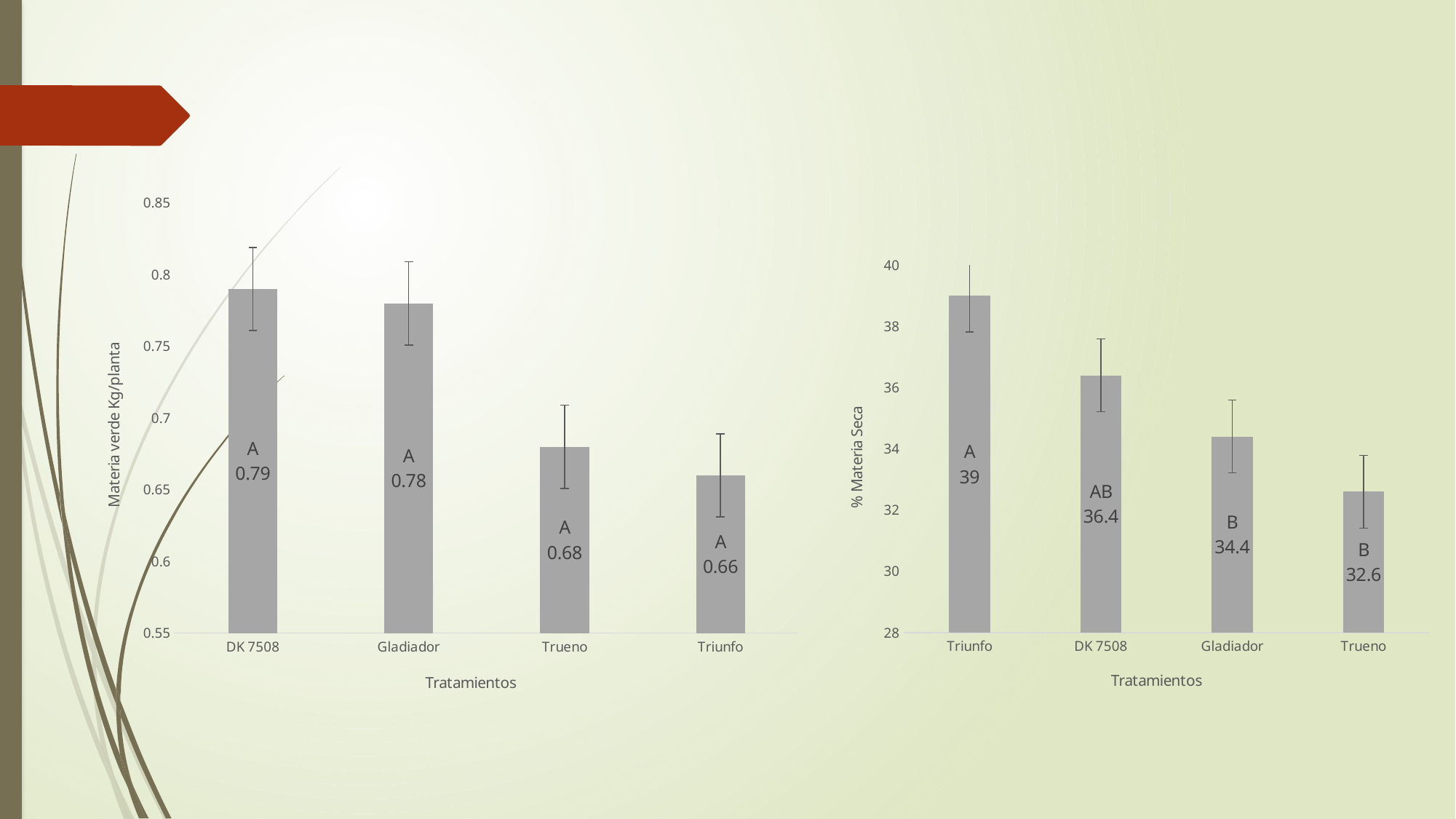
In the left chart (Materia verde Kg/planta), what is the value for Triunfo? 0.66 In the left chart (Materia verde Kg/planta), what is the difference between DK 7508 and Trueno? 0.11 In the right chart (% Materia Seca), which treatment has the highest value? Triunfo In the right chart (% Materia Seca), what is the value for DK 7508? 36.4 What is the x-axis title of the left chart (Materia verde Kg/planta)? Tratamientos In the left chart (Materia verde Kg/planta), how many treatments are shown on the x axis? 4 What kind of chart is the right chart (% Materia Seca)? Bar chart In the right chart (% Materia Seca), which is larger, Gladiador or Trueno? Gladiador In the left chart (Materia verde Kg/planta), what is the value for DK 7508? 0.79 In the right chart (% Materia Seca), what is the difference between Triunfo and Gladiador? 4.6 In the left chart (Materia verde Kg/planta), which treatment has the lowest value? Triunfo In the right chart (% Materia Seca), what is the value for Trueno? 32.6